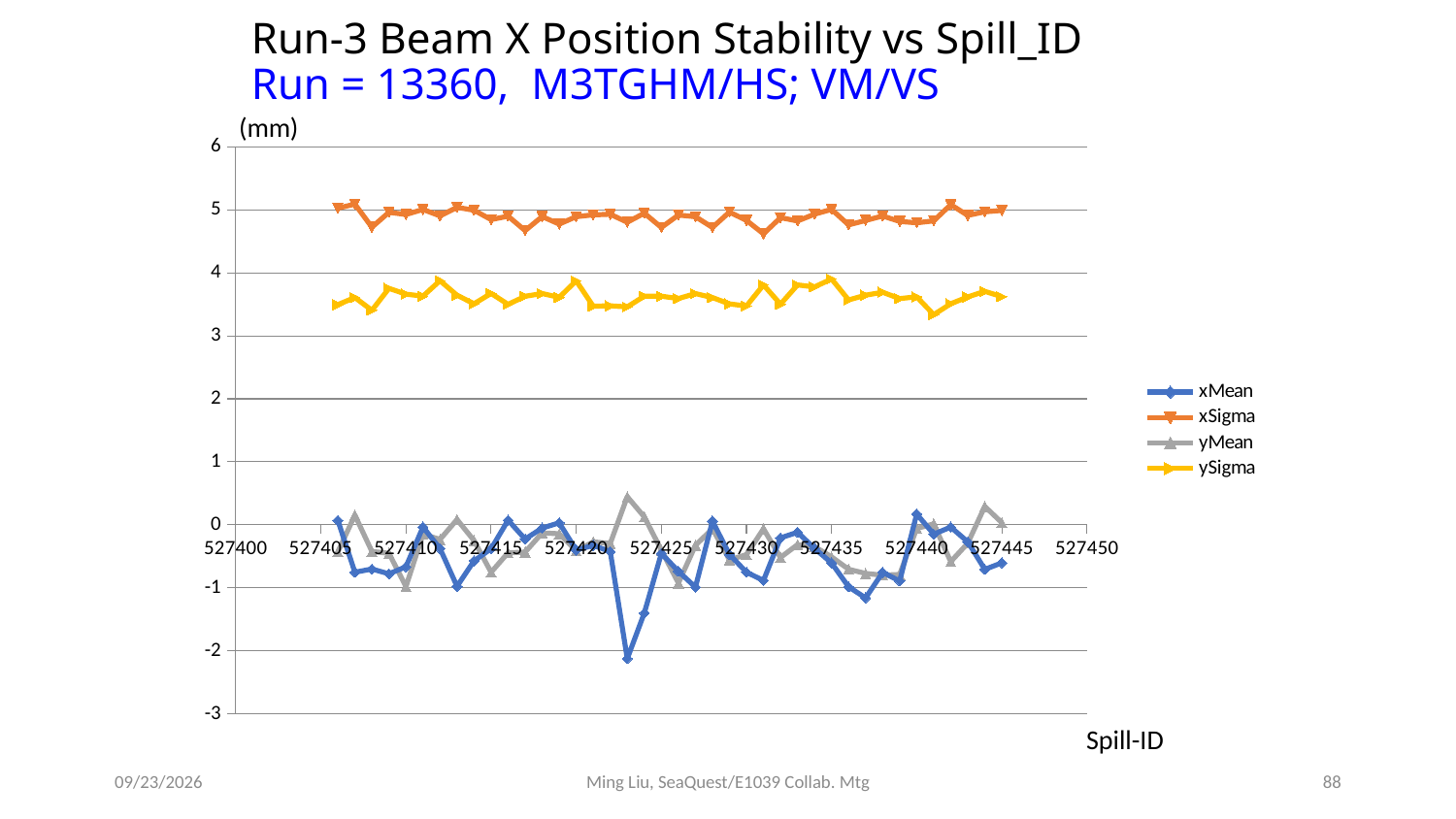
How many series does the legend list? 4 Which series has larger values, xSigma or ySigma? xSigma Which series reaches the lowest value on the chart? xMean Which series has the highest values across the plotted spill range? xSigma What kind of chart is shown on the slide? line chart What is the title of the chart? Run-3 Beam X Position Stability vs Spill_ID Do the xSigma values show a strong rising or falling trend along the x axis, or stay roughly flat? roughly flat Are the xSigma values greater or less than 4? greater Is the lowest xMean value (near Spill-ID 527423) greater or less than -1? less Are the ySigma values greater or less than 3? greater What are the series names listed in the legend? xMean, xSigma, yMean, ySigma